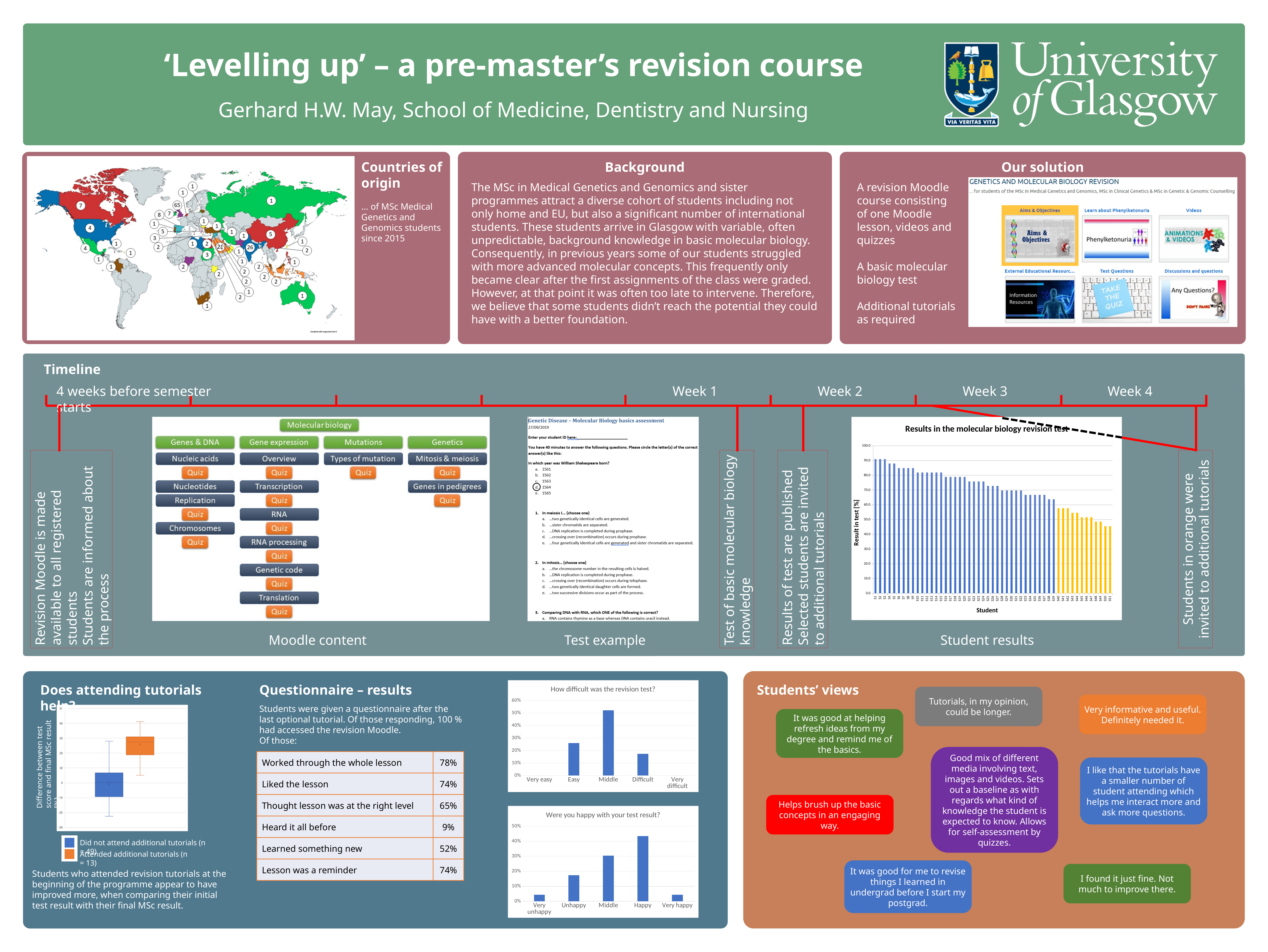
In the chart 'How difficult was the revision test?', how many categories are shown on the x axis? 5 In the chart 'Were you happy with your test result?', is the value for Happy greater or less than 40%? greater In the chart 'How difficult was the revision test?', which category has the highest value? Middle In the chart 'How difficult was the revision test?', is the value for Middle greater or less than 50%? greater In the chart 'Results in the molecular biology revision test', do the values rise or fall from left to right along the x axis? fall What kind of chart is 'Were you happy with your test result?'? bar chart In the chart 'Were you happy with your test result?', which category has the highest value? Happy In the chart 'How difficult was the revision test?', is the value for Easy greater or less than 30%? less In the chart 'Results in the molecular biology revision test', what is the label of the y axis? Result in test [%] In the chart 'How difficult was the revision test?', which is larger, the value for Easy or the value for Difficult? Easy In the box plot under 'Does attending tutorials help?', how many groups does the legend list? 2